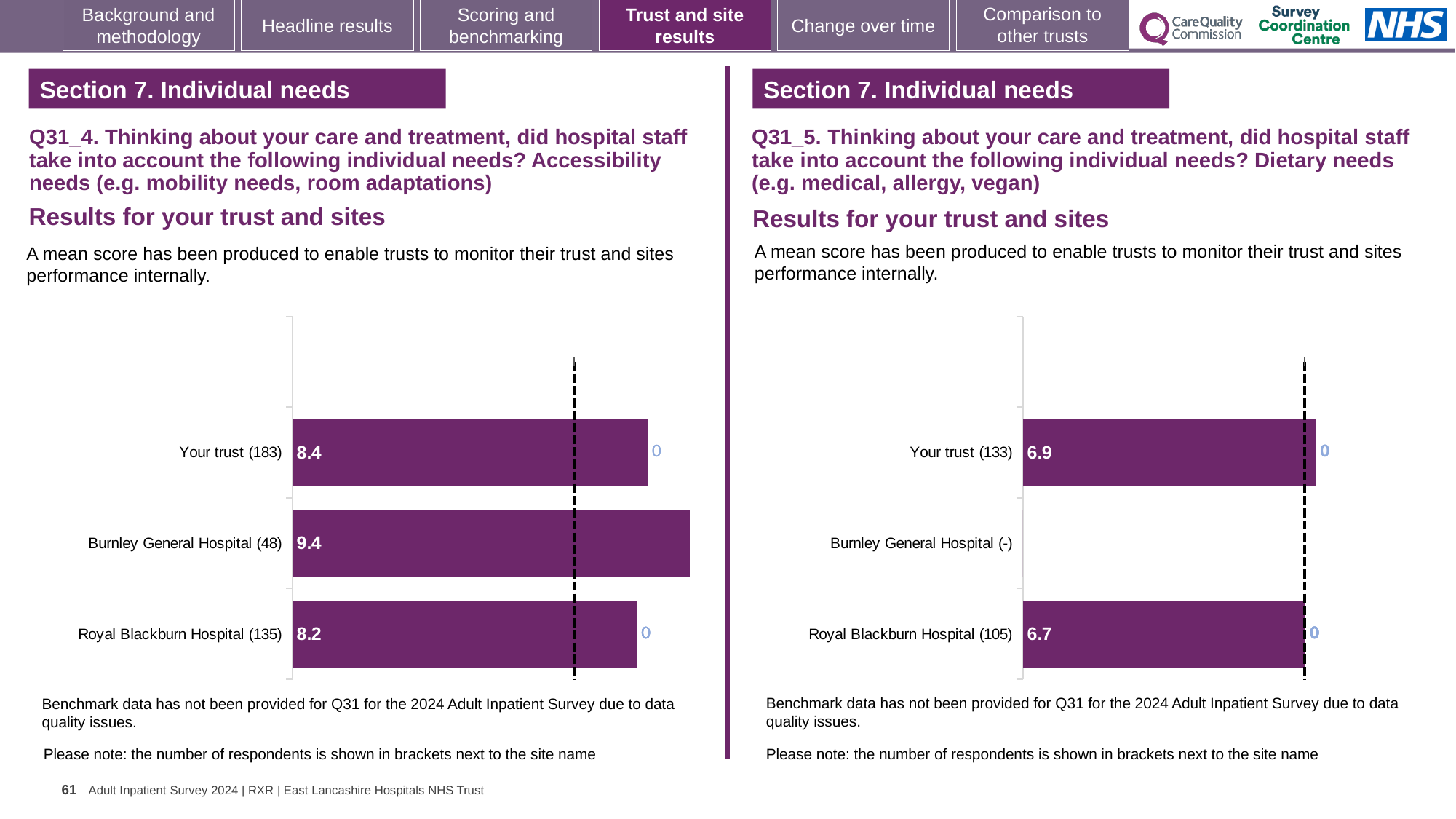
On the right chart (Q31_5, Dietary needs), which has the higher mean score, Your trust or Royal Blackburn Hospital? Your trust On the right chart (Q31_5, Dietary needs), what is the mean score for Your trust? 6.9 On the left chart (Q31_4, Accessibility needs), what is the mean score for Royal Blackburn Hospital? 8.2 On the left chart (Q31_4, Accessibility needs), which site or trust has the highest mean score? Burnley General Hospital What kind of chart is used on the left side of the slide (Q31_4)? Bar chart On the left chart (Q31_4, Accessibility needs), what is the difference between the mean scores of Burnley General Hospital and Royal Blackburn Hospital? 1.2 On the left chart (Q31_4, Accessibility needs), what is the mean score for Burnley General Hospital? 9.4 On the right chart (Q31_5, Dietary needs), what is the mean score for Royal Blackburn Hospital? 6.7 On the left chart (Q31_4, Accessibility needs), how many respondents are shown in brackets for Burnley General Hospital? 48 On the left chart (Q31_4, Accessibility needs), which site or trust has the lowest mean score? Royal Blackburn Hospital On the right chart (Q31_5, Dietary needs), how many respondents are shown in brackets for Royal Blackburn Hospital? 105 On the left chart (Q31_4, Accessibility needs), what is the mean score for Your trust? 8.4